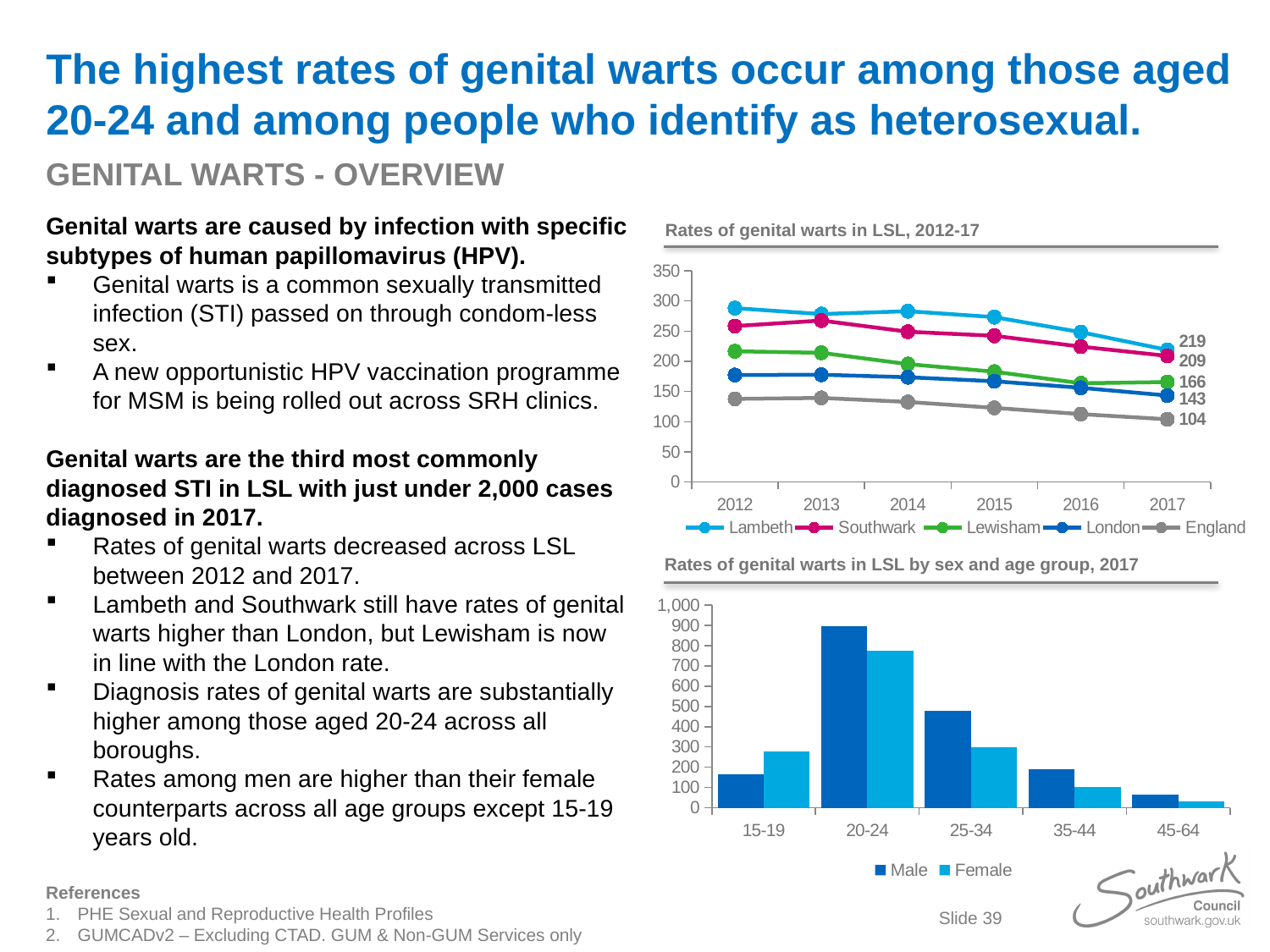
What kind of chart is 'Rates of genital warts in LSL by sex and age group, 2017'? bar chart In the chart 'Rates of genital warts in LSL, 2012-17', what is the value for Lambeth in 2017? 219 In the chart 'Rates of genital warts in LSL, 2012-17', which series has the lowest value in 2017? England In the chart 'Rates of genital warts in LSL, 2012-17', how many series does the legend list? 5 In the chart 'Rates of genital warts in LSL, 2012-17', does the Lambeth line rise or fall between 2012 and 2017? fall In the chart 'Rates of genital warts in LSL, 2012-17', what is the difference between the Southwark and London values in 2017? 66 In the chart 'Rates of genital warts in LSL, 2012-17', which series has the highest value in 2017? Lambeth In the chart 'Rates of genital warts in LSL by sex and age group, 2017', which age group has the highest Male value? 20-24 In the chart 'Rates of genital warts in LSL by sex and age group, 2017', is the Female value for 20-24 greater or less than 700? greater In the chart 'Rates of genital warts in LSL, 2012-17', what is the value for England in 2017? 104 In the chart 'Rates of genital warts in LSL, 2012-17', is the value for Lambeth in 2012 greater or less than 250? greater In the chart 'Rates of genital warts in LSL, 2012-17', what is the value for Lewisham in 2017? 166